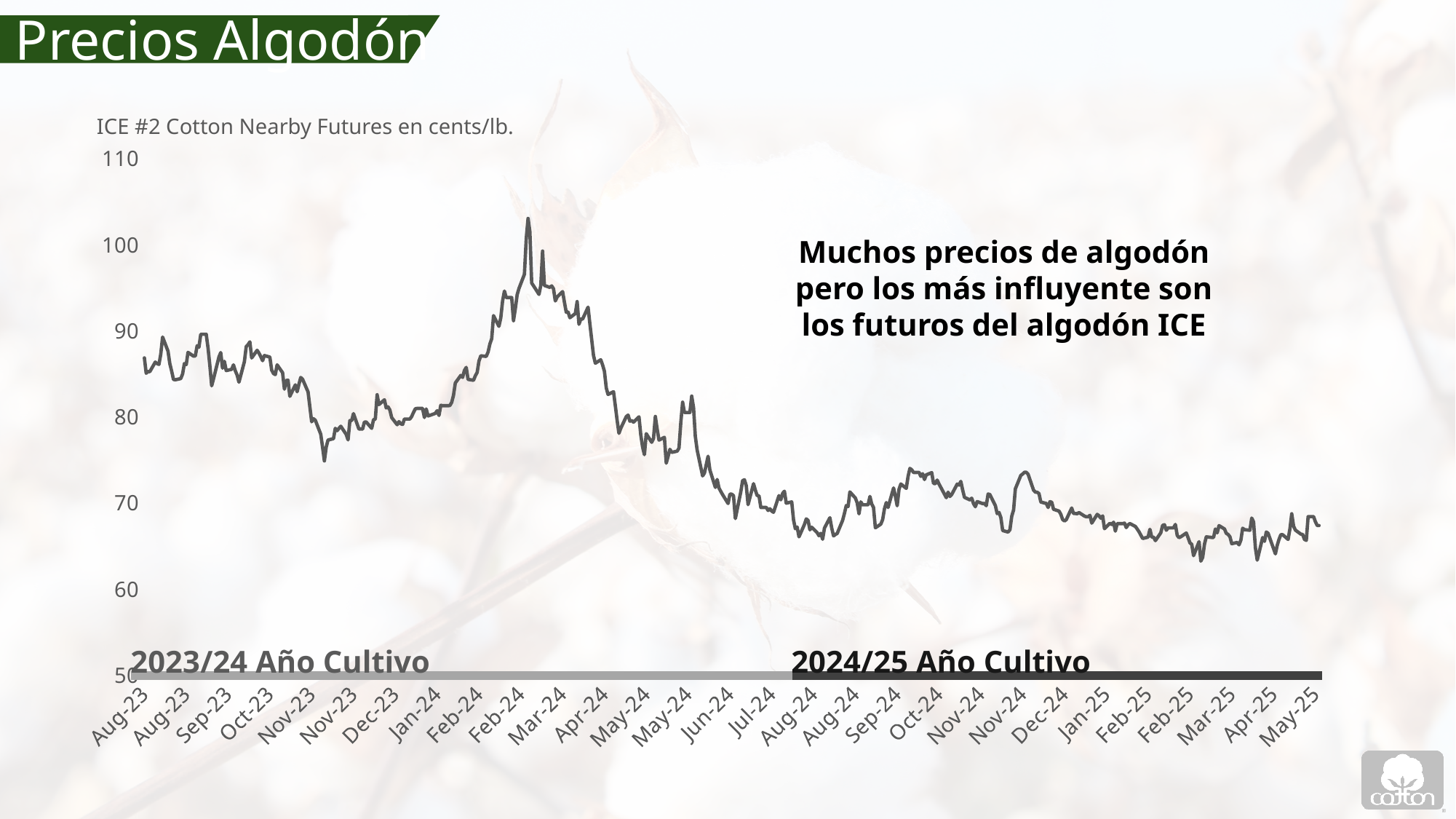
What kind of chart is shown on the slide? line chart How many data series are plotted on the chart? 1 Is the value around Jan-25 greater or less than 70? less Is the value at the start of the line in Aug-23 higher or lower than the value at the end in May-25? higher What are the two crop-year periods labelled along the bottom of the chart? 2023/24 Año Cultivo and 2024/25 Año Cultivo Is the value at the end of the line in May-25 greater or less than 70? less What is the title of the chart? ICE #2 Cotton Nearby Futures en cents/lb. Is the value around Jun-24 greater or less than 80? less In which month does the line reach its highest value? Feb-24 Does the line generally rise or fall from its Feb-24 peak to May-25? fall